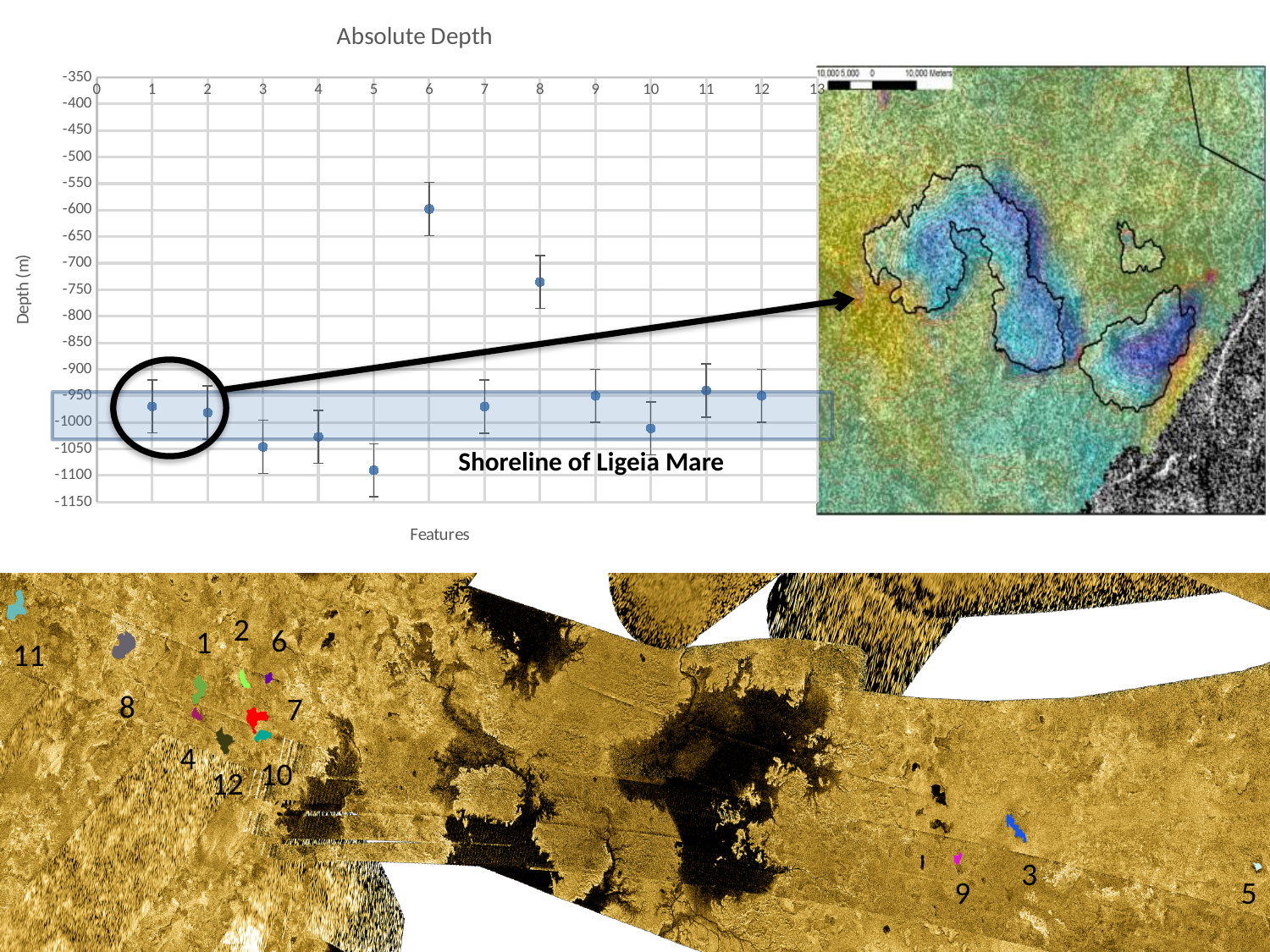
Which has the higher depth value, feature 1 or feature 5? feature 1 Which feature has the highest (shallowest) depth value in the chart? 6 Is the depth value for feature 3 greater or less than -1000? less How many features (data points) are plotted in the chart? 12 Is the depth value for feature 6 greater or less than -700? greater What kind of chart is shown on the slide? scatter chart Which has the higher depth value, feature 6 or feature 8? feature 6 What is the title of the chart? Absolute Depth Is the depth value for feature 5 greater or less than -1050? less What label is written on the shaded horizontal band in the chart? Shoreline of Ligeia Mare Which feature has the lowest (deepest) depth value in the chart? 5